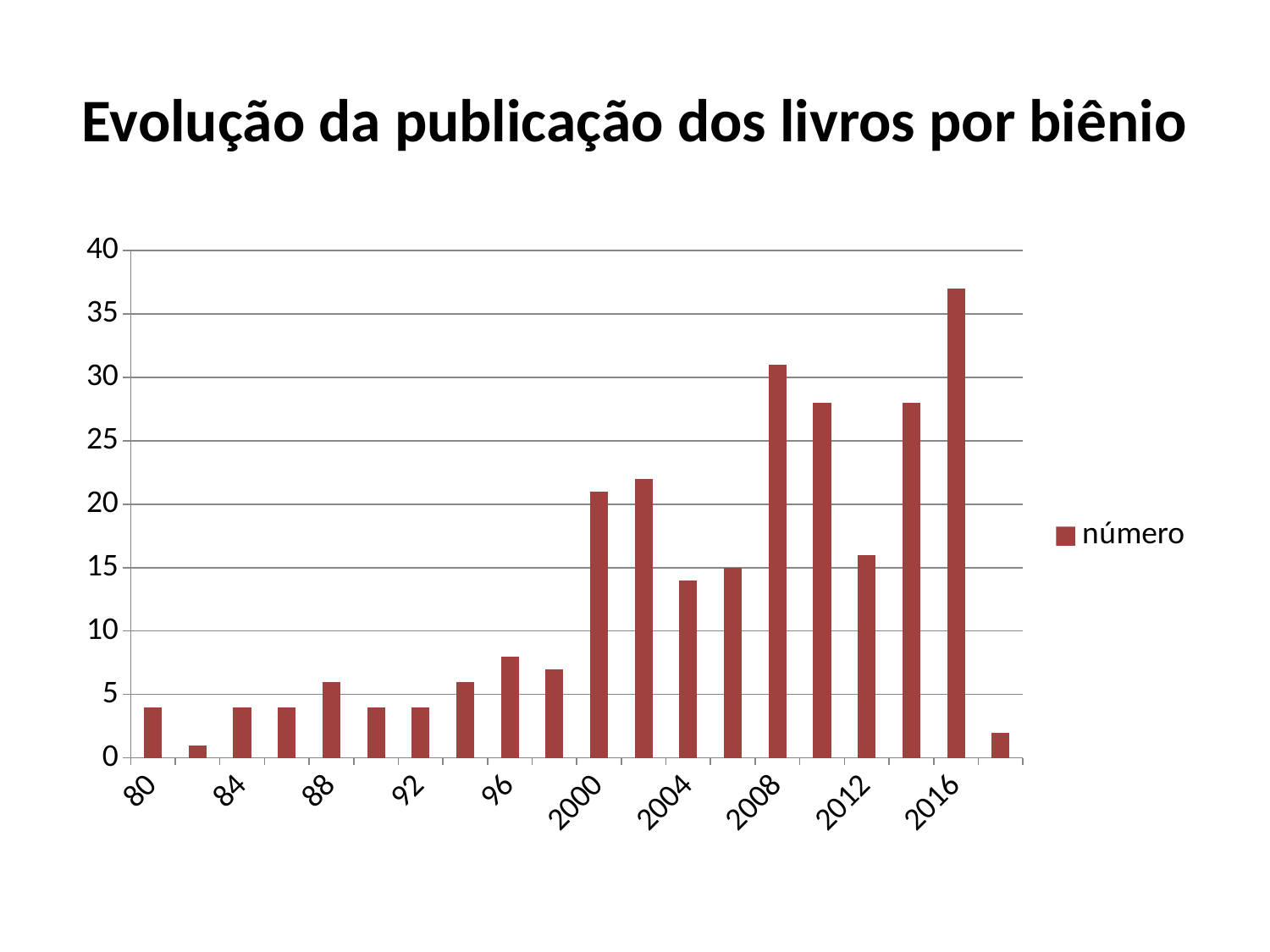
Which is larger, the value for 2008 or the value for 2012? 2008 How many bars are plotted in the chart? 20 Is the value for 2000 greater or less than 20? greater Is the value for 2016 greater or less than 35? greater What is the title of the chart? Evolução da publicação dos livros por biênio What kind of chart is shown on the slide? bar chart How many series does the legend list? 1 Which labeled year has the highest bar? 2016 Is the value for 80 greater or less than 5? less Do the values generally rise or fall from 80 to 2016? rise What is the name of the series shown in the legend? número